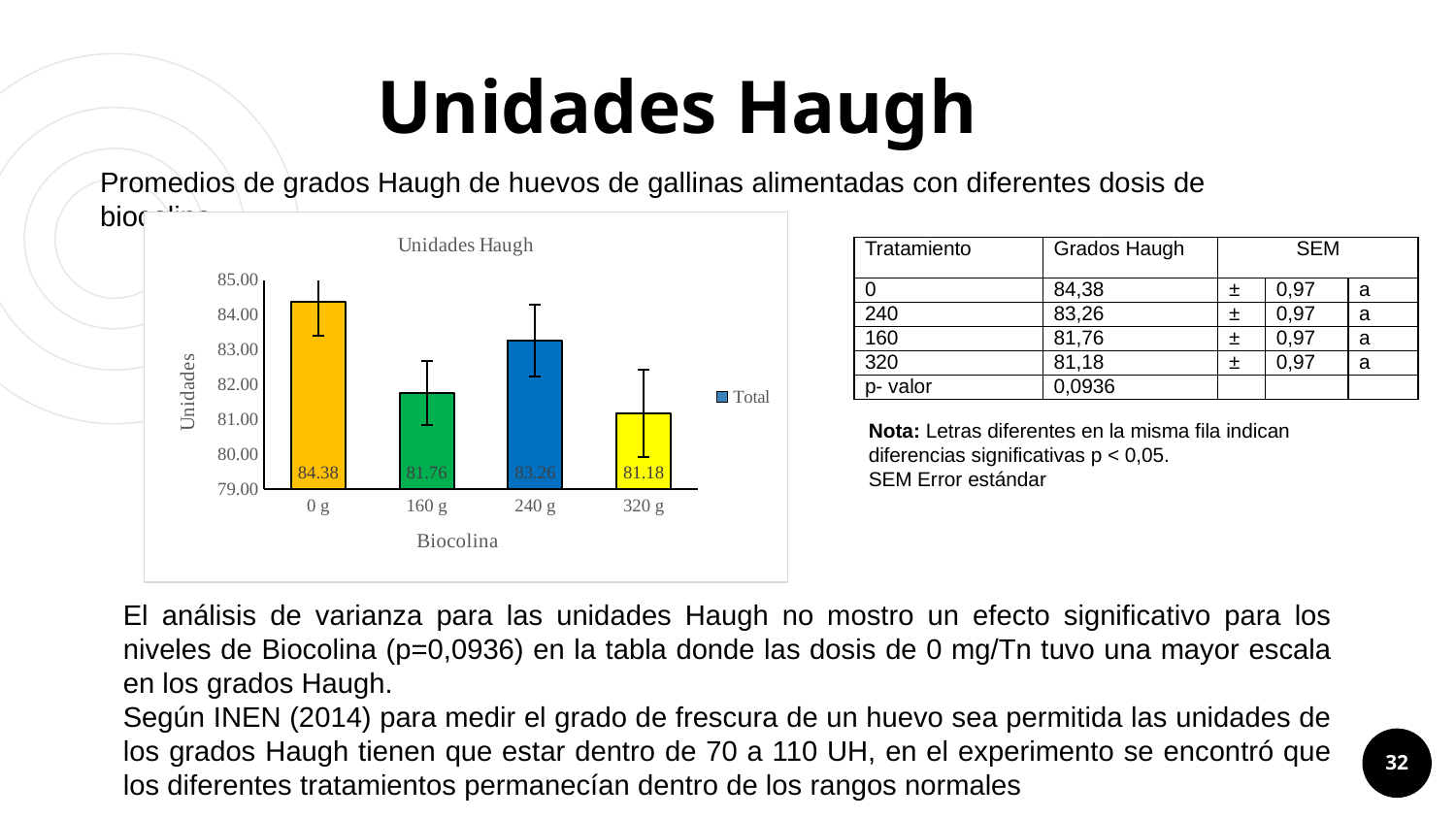
What is the value for 160 g in the Unidades Haugh chart? 81.76 Which Biocolina dose has the highest value in the Unidades Haugh chart? 0 g What is the label of the y axis in the Unidades Haugh chart? Unidades Is the value for 240 g in the Unidades Haugh chart greater or less than 83.00? greater Which Biocolina dose has the lowest value in the Unidades Haugh chart? 320 g Which is larger in the Unidades Haugh chart, the value for 160 g or the value for 240 g? 240 g How many Biocolina doses are shown on the x axis of the Unidades Haugh chart? 4 What is the value for 0 g in the Unidades Haugh chart? 84.38 What type of chart is the Unidades Haugh chart? bar chart What is the value for 240 g in the Unidades Haugh chart? 83.26 What is the difference between the values for 0 g and 320 g in the Unidades Haugh chart? 3.20 What is the value for 320 g in the Unidades Haugh chart? 81.18